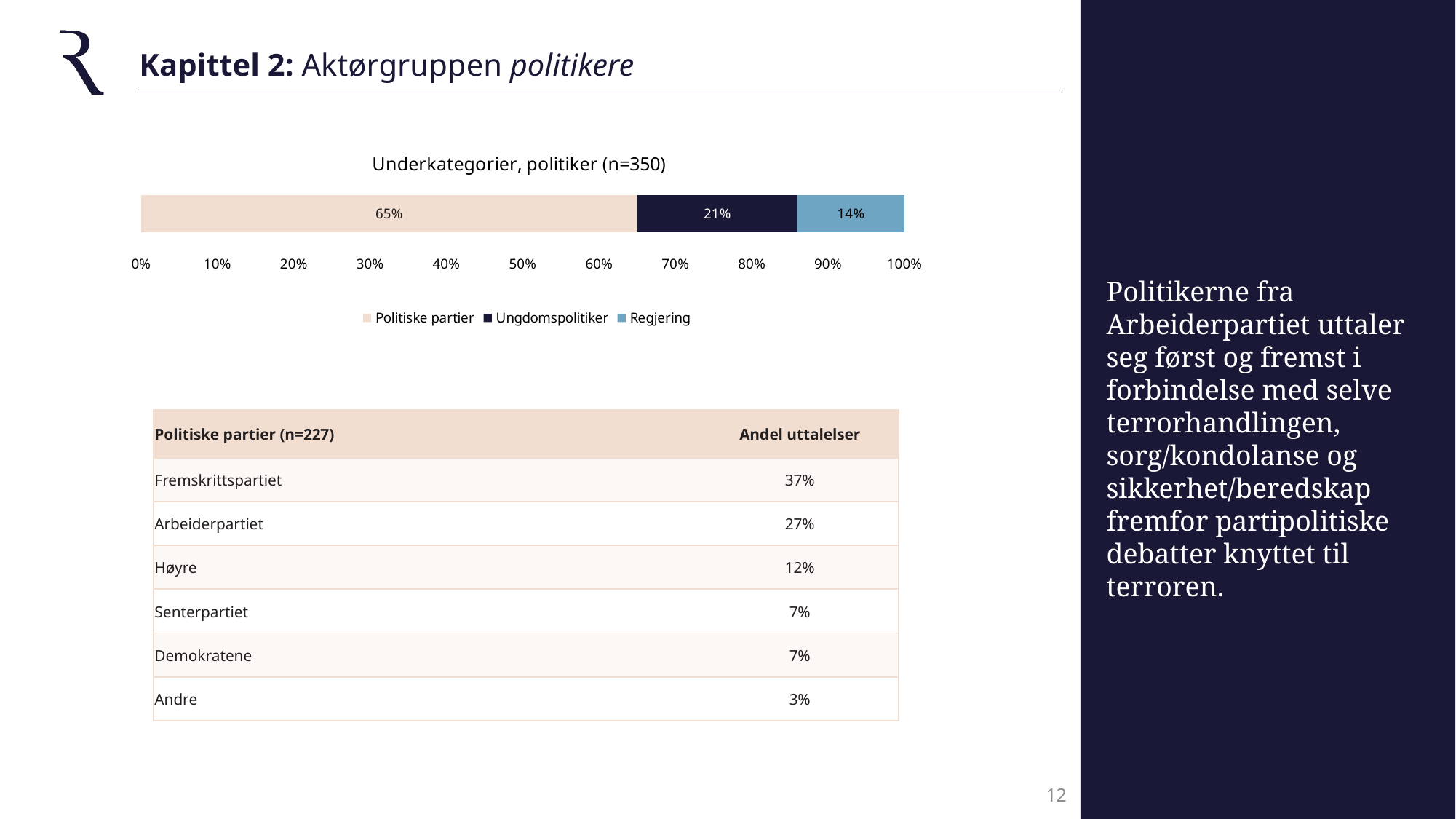
Which series has the smallest share in the chart? Regjering What is the value for Ungdomspolitiker in the chart? 21% What is the value for Politiske partier in the chart? 65% What is the difference between the values for Politiske partier and Ungdomspolitiker? 44% What is the value for Regjering in the chart? 14% What is the total of the three segments in the stacked bar? 100% Which series has the largest share in the chart? Politiske partier What is the title of the chart? Underkategorier, politiker (n=350) Which is larger, the value for Ungdomspolitiker or the value for Regjering? Ungdomspolitiker What type of chart is shown on the slide? Stacked bar chart How many series does the chart legend list? 3 Is the value for Politiske partier greater or less than 60%? greater